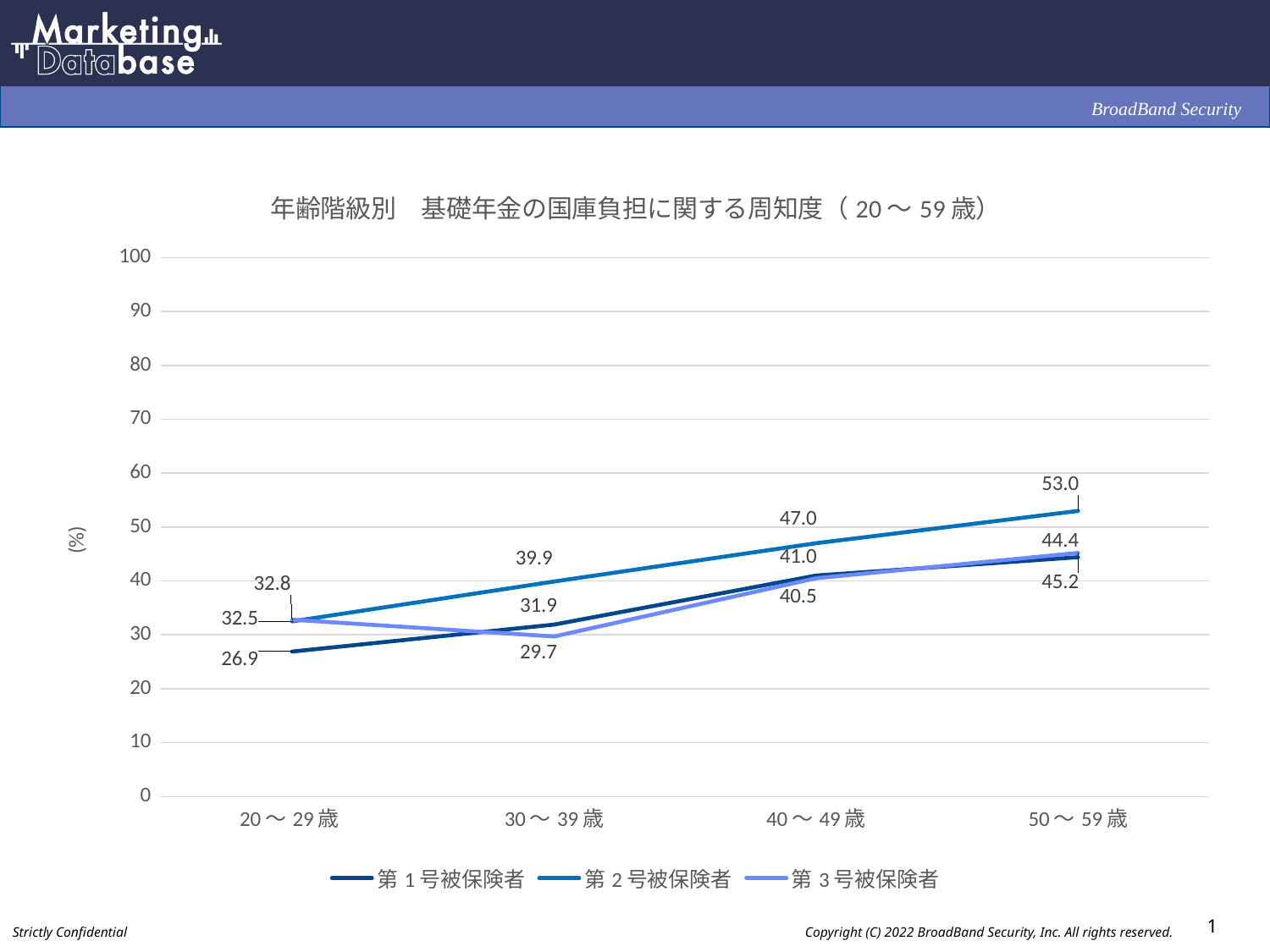
Which series has the highest value in the 50～59歳 group? 第2号被保険者 How many age groups are shown on the x axis? 4 How many series does the legend list? 3 What is the value for 第2号被保険者 in the 50～59歳 group? 53.0 What is the difference between the 第2号被保険者 values for 50～59歳 and 40～49歳? 6.0 In which age group is the value for 第1号被保険者 lowest? 20～29歳 What is the value for 第3号被保険者 in the 30～39歳 group? 29.7 What is the value for 第2号被保険者 in the 40～49歳 group? 47.0 What is the title of the chart? 年齢階級別 基礎年金の国庫負担に関する周知度（20～59歳） What kind of chart is shown on the slide? line chart Does the value for 第2号被保険者 rise or fall from 20～29歳 to 50～59歳? rise What is the value for 第1号被保険者 in the 20～29歳 group? 26.9